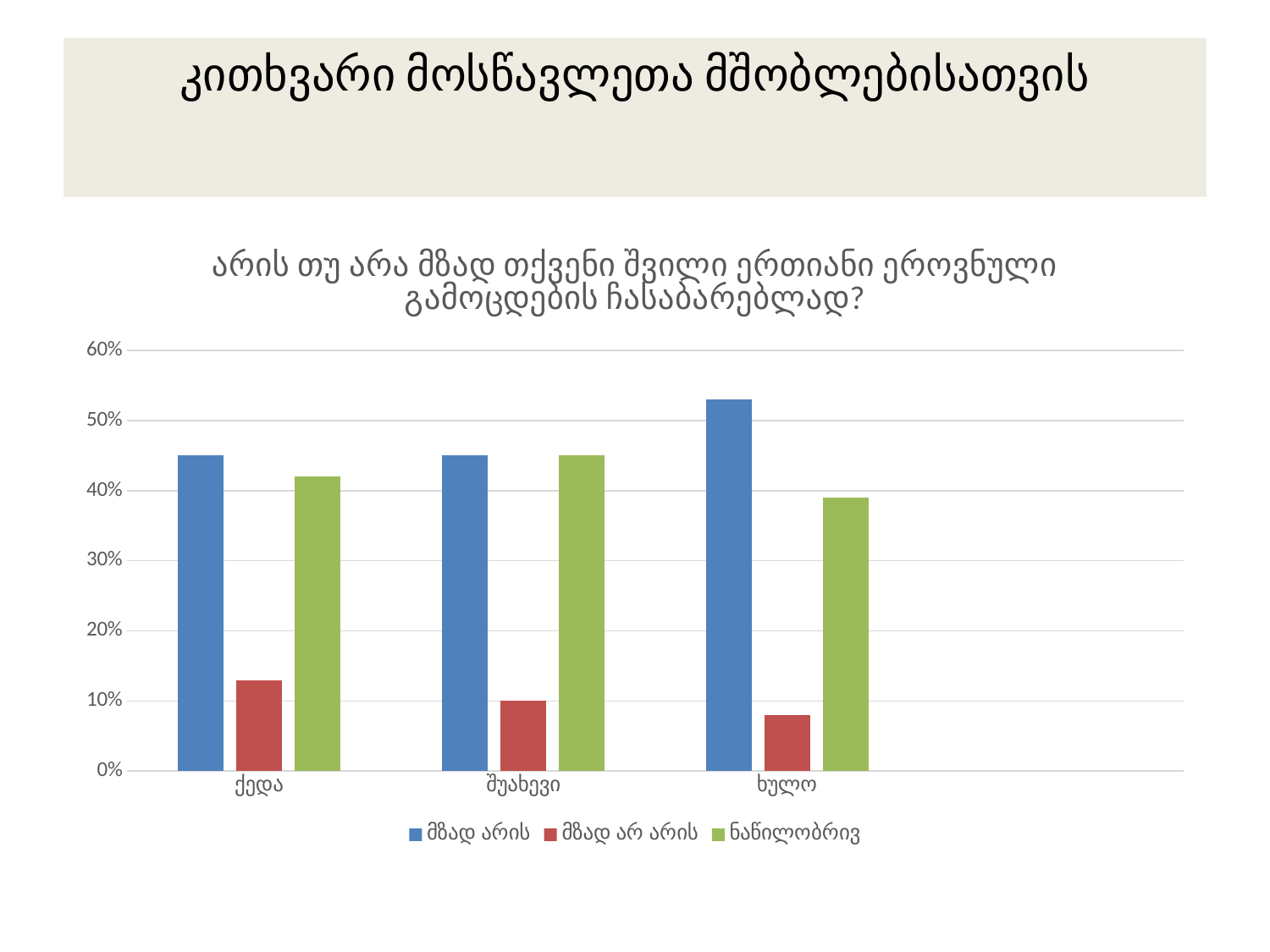
Is the value for მზად არის in ხულო greater or less than 50%? greater Is the value for მზად არ არის in ქედა greater or less than 20%? less Is the value for ნაწილობრივ in ქედა greater or less than 30%? greater In ხულო, which is larger: მზად არის or ნაწილობრივ? მზად არის Which category has the highest value for მზად არ არის? ქედა In ქედა, which is larger: მზად არის or მზად არ არის? მზად არის Which colour represents the series ნაწილობრივ in the chart? green How many series does the chart legend list? 3 Which category has the highest value for მზად არის? ხულო What kind of chart is shown on the slide? bar chart Which category has the lowest value for მზად არ არის? ხულო How many categories are shown on the x axis of the chart? 3